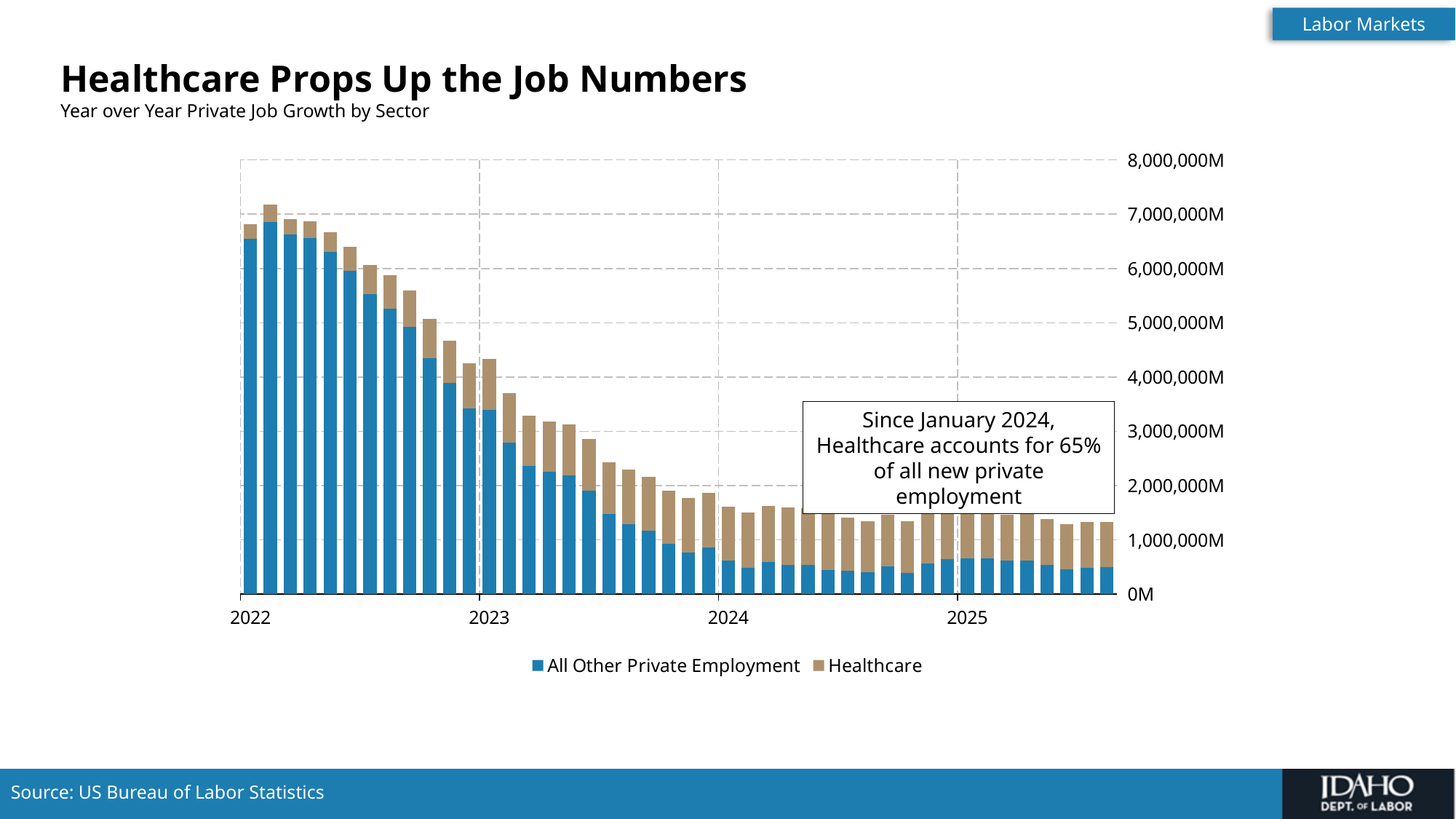
Is the total bar at the 2022 tick greater or less than 6,000,000M? greater Is the total bar at the 2025 tick greater or less than 2,000,000M? less According to the annotation on the chart, what share of all new private employment has Healthcare accounted for since January 2024? 65% Do the total bar heights generally rise or fall from 2022 to 2025? Fall In the bar at the 2025 tick, which series makes up the larger portion? Healthcare Is the total bar at the 2024 tick greater or less than 3,000,000M? less Which is larger, the total bar at the 2022 tick or the total bar at the 2025 tick? 2022 How many series does the legend list? 2 In the bar at the 2022 tick, which series makes up the larger portion? All Other Private Employment What are the two series shown in the legend? All Other Private Employment and Healthcare What kind of chart is shown on the slide? Stacked bar chart